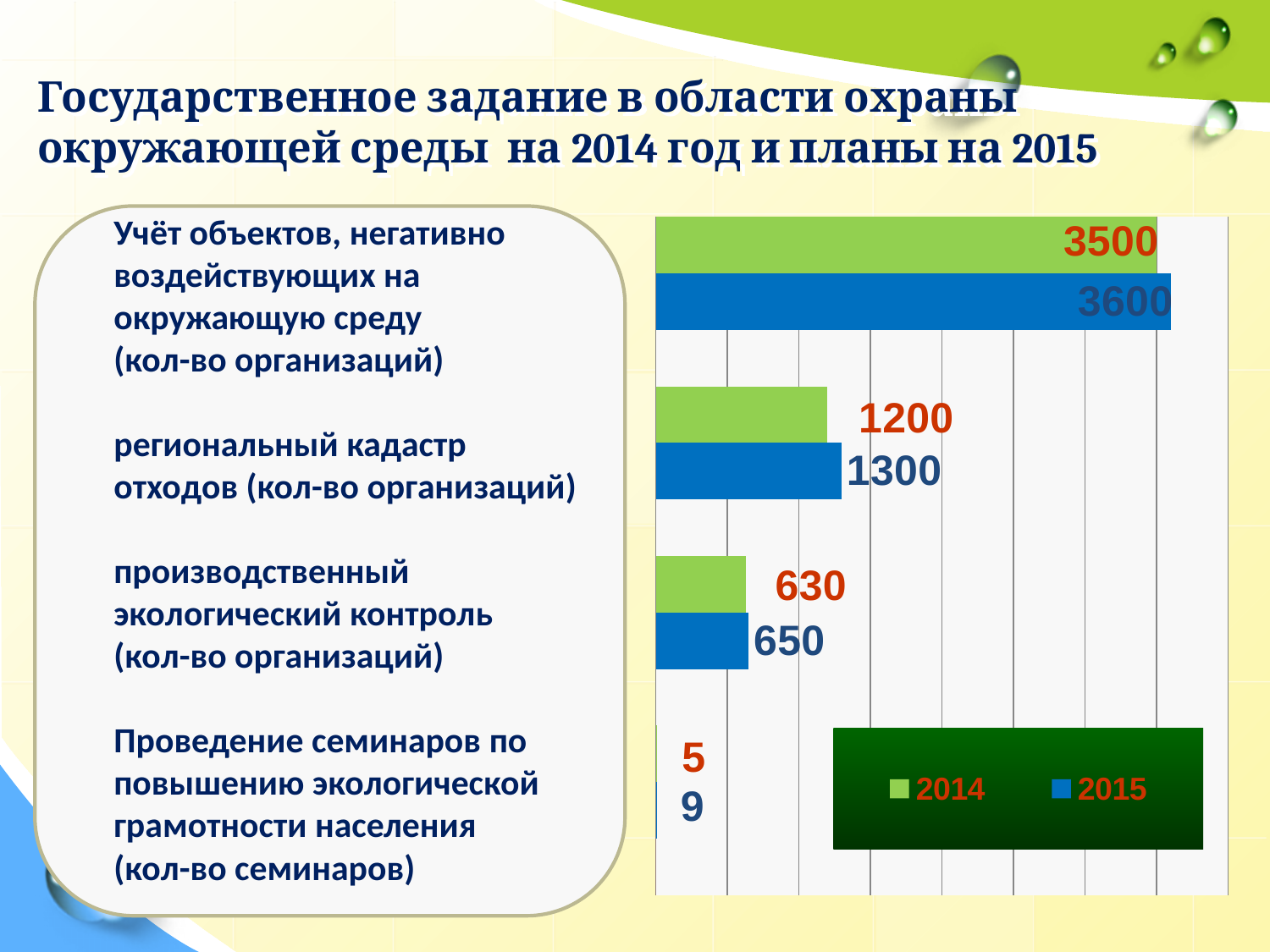
Which colour represents the 2014 series in the chart? Green What is the 2015 value for «региональный кадастр отходов»? 1300 How many series does the legend list? 2 How many categories does the chart show? 4 What is the difference between the 2015 and 2014 values for «региональный кадастр отходов»? 100 What is the 2015 value for «Проведение семинаров по повышению экологической грамотности населения»? 9 Which category has the lowest 2014 value? Проведение семинаров по повышению экологической грамотности населения What is the 2014 value for «Учёт объектов, негативно воздействующих на окружающую среду»? 3500 What kind of chart is shown on the slide? Bar chart What is the 2014 value for «производственный экологический контроль»? 630 Which is larger for «производственный экологический контроль»: the 2014 value or the 2015 value? 2015 Which category has the highest 2015 value? Учёт объектов, негативно воздействующих на окружающую среду